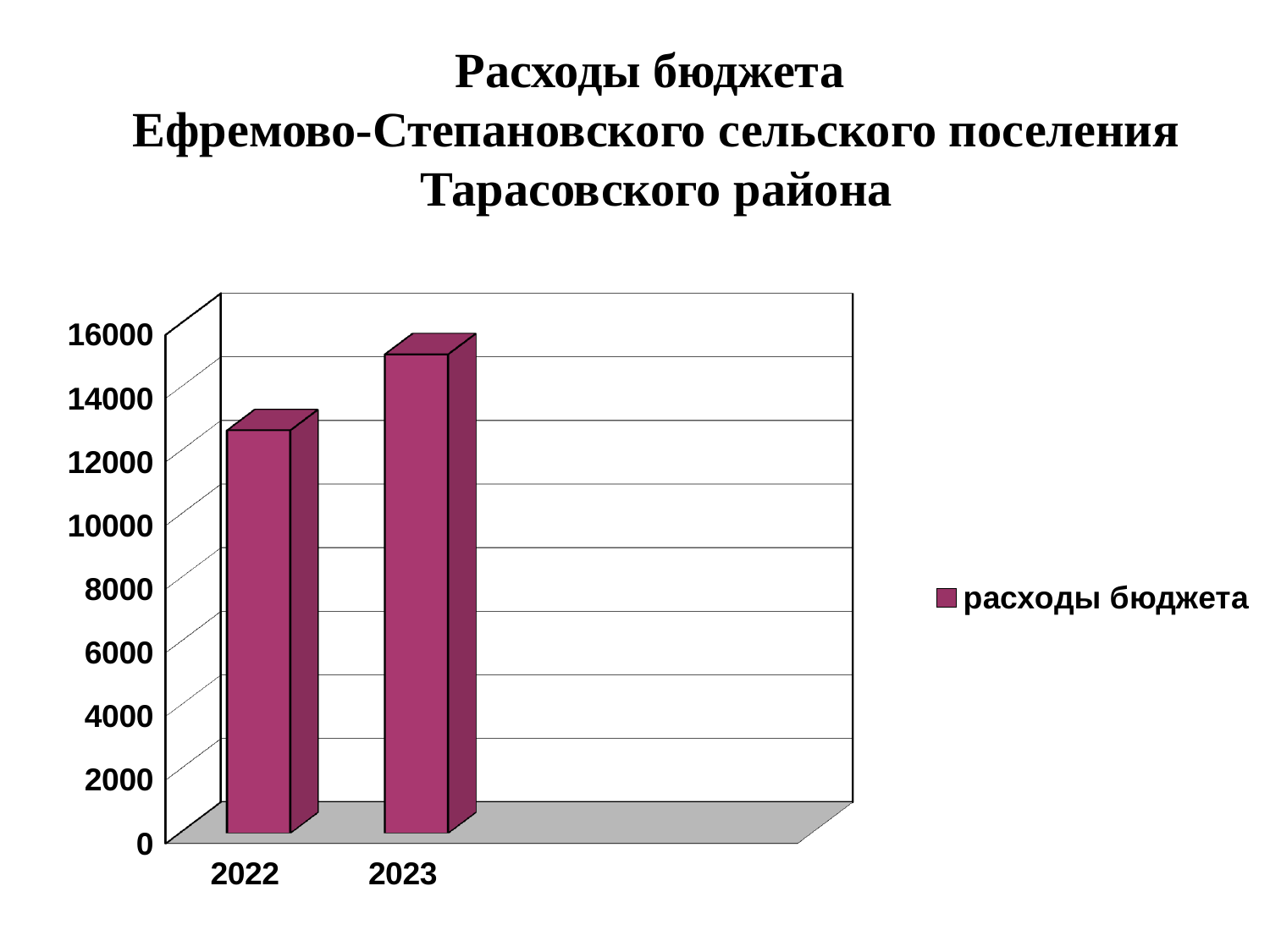
What is the name of the series listed in the chart's legend? расходы бюджета Is the value for 2022 greater or less than 14000? less What kind of chart is shown on the slide? bar chart Is the value for 2022 greater or less than 10000? greater Is the value for 2023 greater or less than 16000? less Which year has the highest budget expenditure in the chart? 2023 How many categories (years) are shown on the x axis of the chart? 2 Which year has the lowest budget expenditure in the chart? 2022 Which is larger, the value for 2022 or the value for 2023? 2023 Do the values rise or fall from 2022 to 2023? rise How many series does the chart's legend list? 1